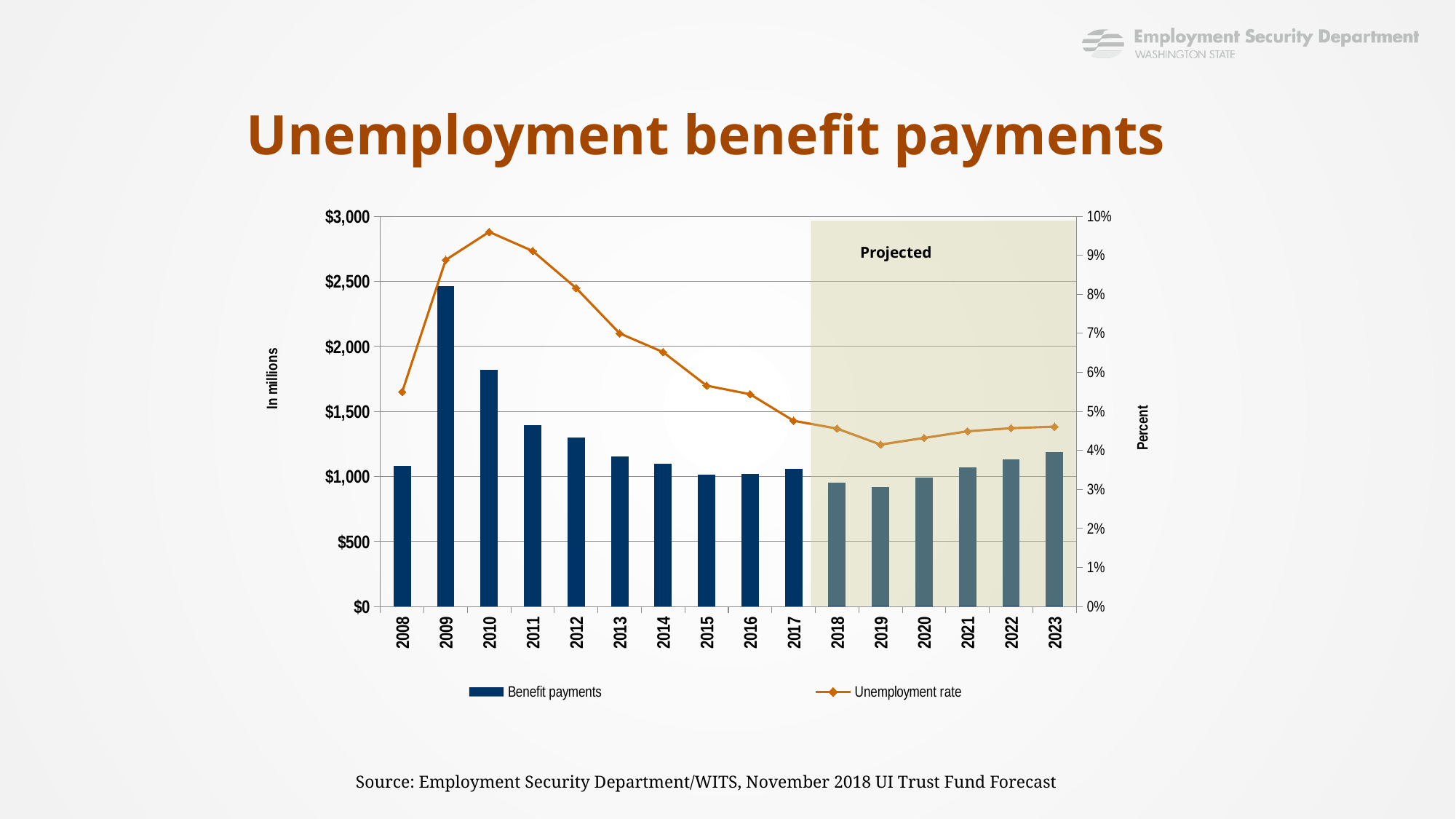
What kind of chart is this? Combined bar and line chart How many series does the legend list? 2 Are benefit payments in 2019 greater or less than $1,000 million? less Is the unemployment rate in 2010 greater or less than 9%? greater Does the unemployment rate rise or fall from 2010 to 2019? fall Are benefit payments in 2009 greater or less than $2,000 million? greater How many years are shown on the x axis? 16 Which year has the lowest unemployment rate? 2019 Which year has the highest benefit payments? 2009 Which year has the highest unemployment rate? 2010 Which year has higher benefit payments, 2010 or 2011? 2010